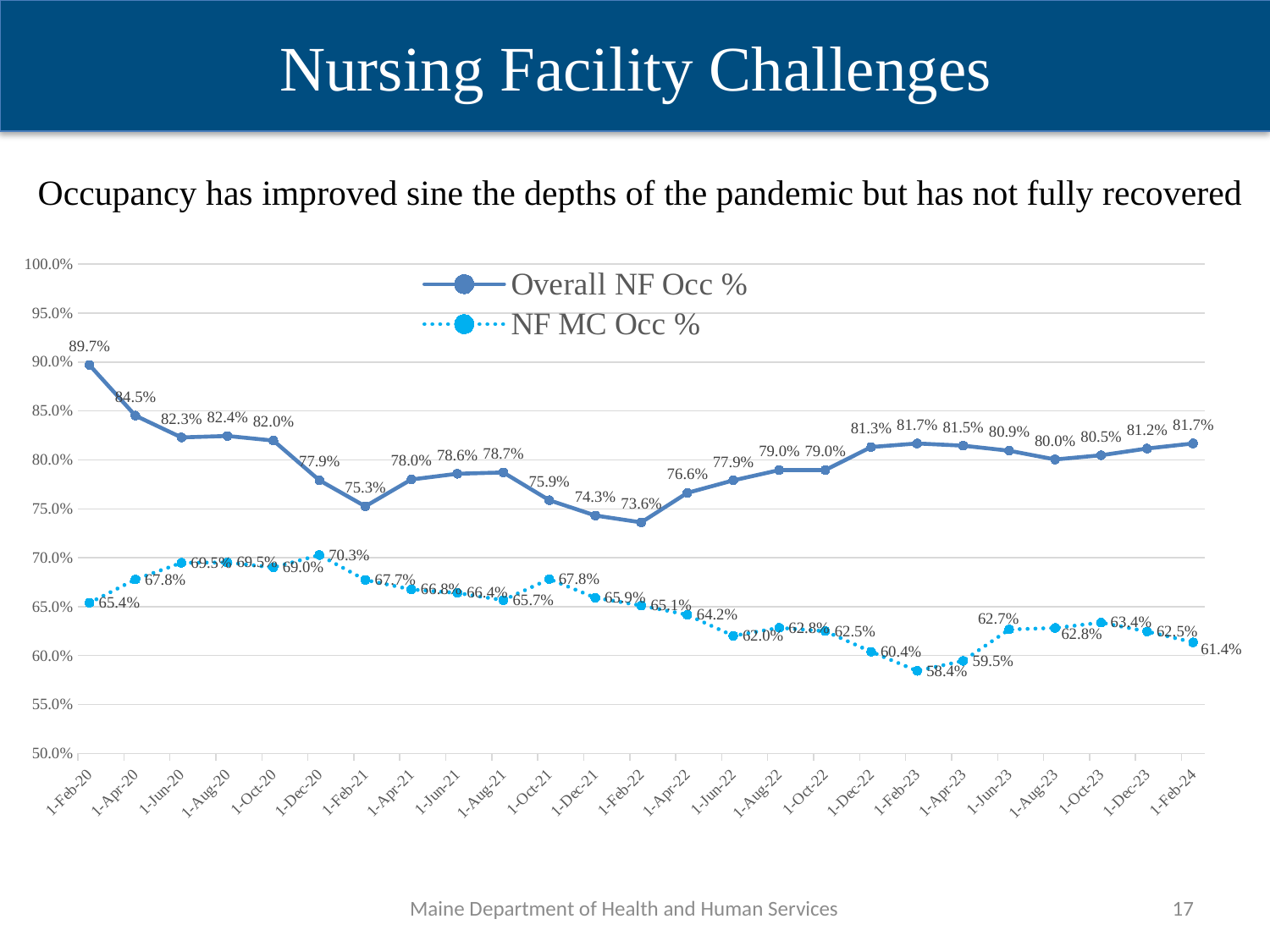
At which date is the Overall NF Occ % series at its lowest? 1-Feb-22 Which is higher for Overall NF Occ %: 1-Feb-21 or 1-Apr-21? 1-Apr-21 What is the NF MC Occ % value at 1-Feb-24? 61.4% What kind of chart is shown on the slide? Line chart At which date is the NF MC Occ % series at its lowest? 1-Feb-23 By how many percentage points did Overall NF Occ % fall from 1-Feb-20 to 1-Feb-24? 8.0 percentage points At which date is the Overall NF Occ % series at its highest? 1-Feb-20 At which date is the NF MC Occ % series at its highest? 1-Dec-20 What is the Overall NF Occ % value at 1-Feb-22? 73.6% What is the Overall NF Occ % value at 1-Feb-20? 89.7% What is the gap between Overall NF Occ % and NF MC Occ % at 1-Feb-24? 20.3 percentage points How many series does the legend list? 2